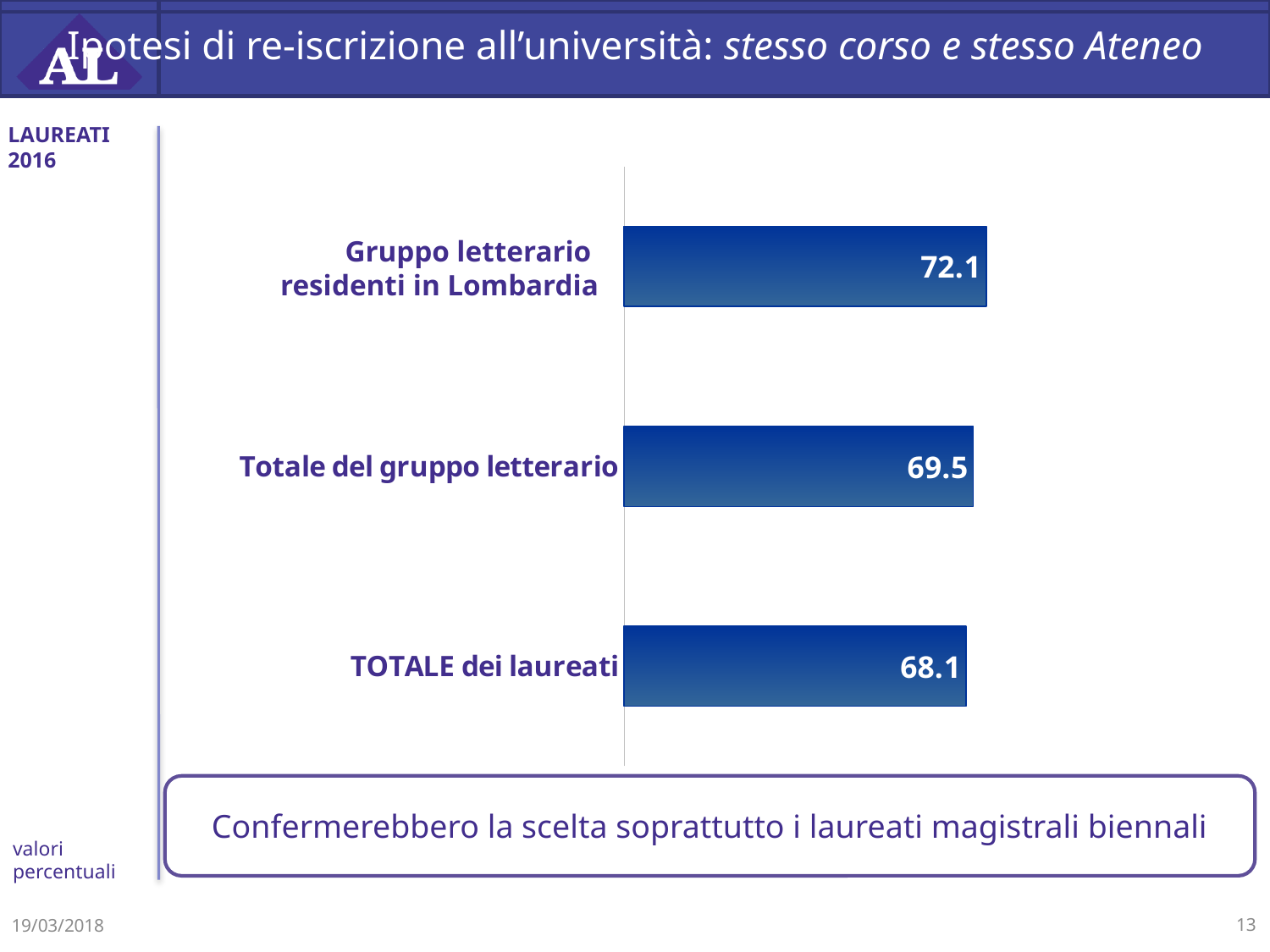
What is the title of the slide containing the chart? Ipotesi di re-iscrizione all'università: stesso corso e stesso Ateneo What is the value for Totale del gruppo letterario? 69.5 In what unit are the chart values expressed, according to the note on the slide? valori percentuali What is the difference between the values for Gruppo letterario residenti in Lombardia and TOTALE dei laureati? 4.0 How many categories are shown in the chart? 3 Which is larger, the value for Gruppo letterario residenti in Lombardia or the value for Totale del gruppo letterario? Gruppo letterario residenti in Lombardia What is the value for Gruppo letterario residenti in Lombardia? 72.1 What kind of chart is shown on the slide? Bar chart What is the difference between the values for Totale del gruppo letterario and TOTALE dei laureati? 1.4 What is the value for TOTALE dei laureati? 68.1 Which category has the lowest value? TOTALE dei laureati Which category has the highest value? Gruppo letterario residenti in Lombardia